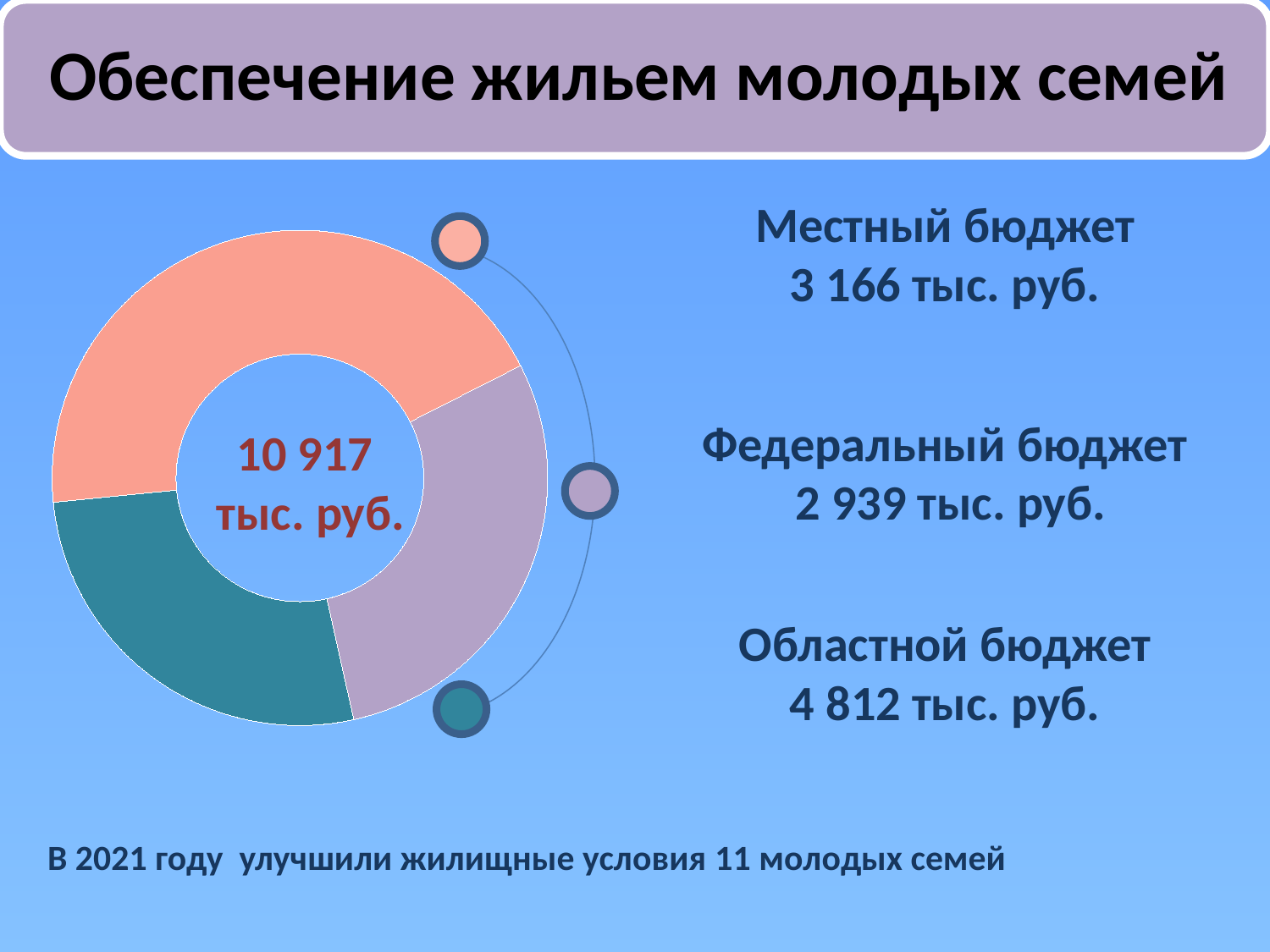
Which budget source contributes the smallest amount? Федеральный бюджет What is the value for Местный бюджет? 3 166 тыс. руб. What colour is the segment representing Областной бюджет? Teal (dark green-blue) What is the difference between Областной бюджет and Местный бюджет? 1 646 тыс. руб. What is the value for Федеральный бюджет? 2 939 тыс. руб. What type of chart is shown on the slide? Donut (pie) chart What is the value for Областной бюджет? 4 812 тыс. руб. How many budget categories does the donut chart show? 3 What is the difference between Местный бюджет and Федеральный бюджет? 227 тыс. руб. Which budget source contributes the largest amount? Областной бюджет What total value is shown in the centre of the donut chart? 10 917 тыс. руб. Which is larger, Областной бюджет or Федеральный бюджет? Областной бюджет